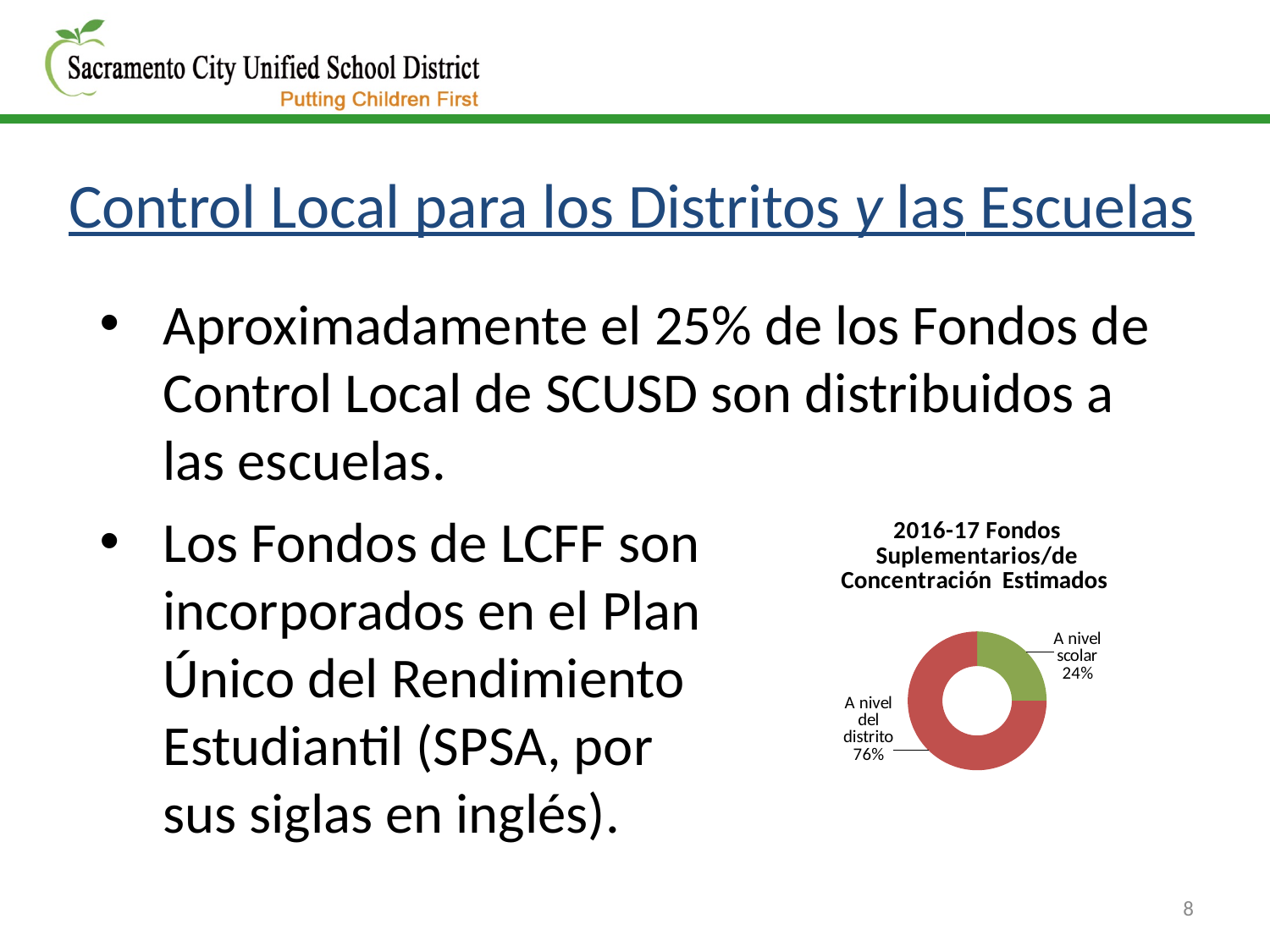
What share of the doughnut chart is labelled 'A nivel del distrito'? 76% Is the share for 'A nivel scolar' greater or less than 50%? less How many slices does the doughnut chart have? 2 What kind of chart is shown on the slide? Doughnut chart What is the title of the chart on the slide? 2016-17 Fondos Suplementarios/de Concentración Estimados What do the two slices of the doughnut chart add up to? 100% What share of the doughnut chart is labelled 'A nivel scolar'? 24% Which is larger in the doughnut chart: 'A nivel scolar' or 'A nivel del distrito'? A nivel del distrito What colour is the 'A nivel del distrito' slice in the doughnut chart? Red What is the difference in percentage points between the 'A nivel del distrito' slice and the 'A nivel scolar' slice? 52 percentage points Which slice of the doughnut chart is the largest? A nivel del distrito Which slice of the doughnut chart is the smallest? A nivel scolar